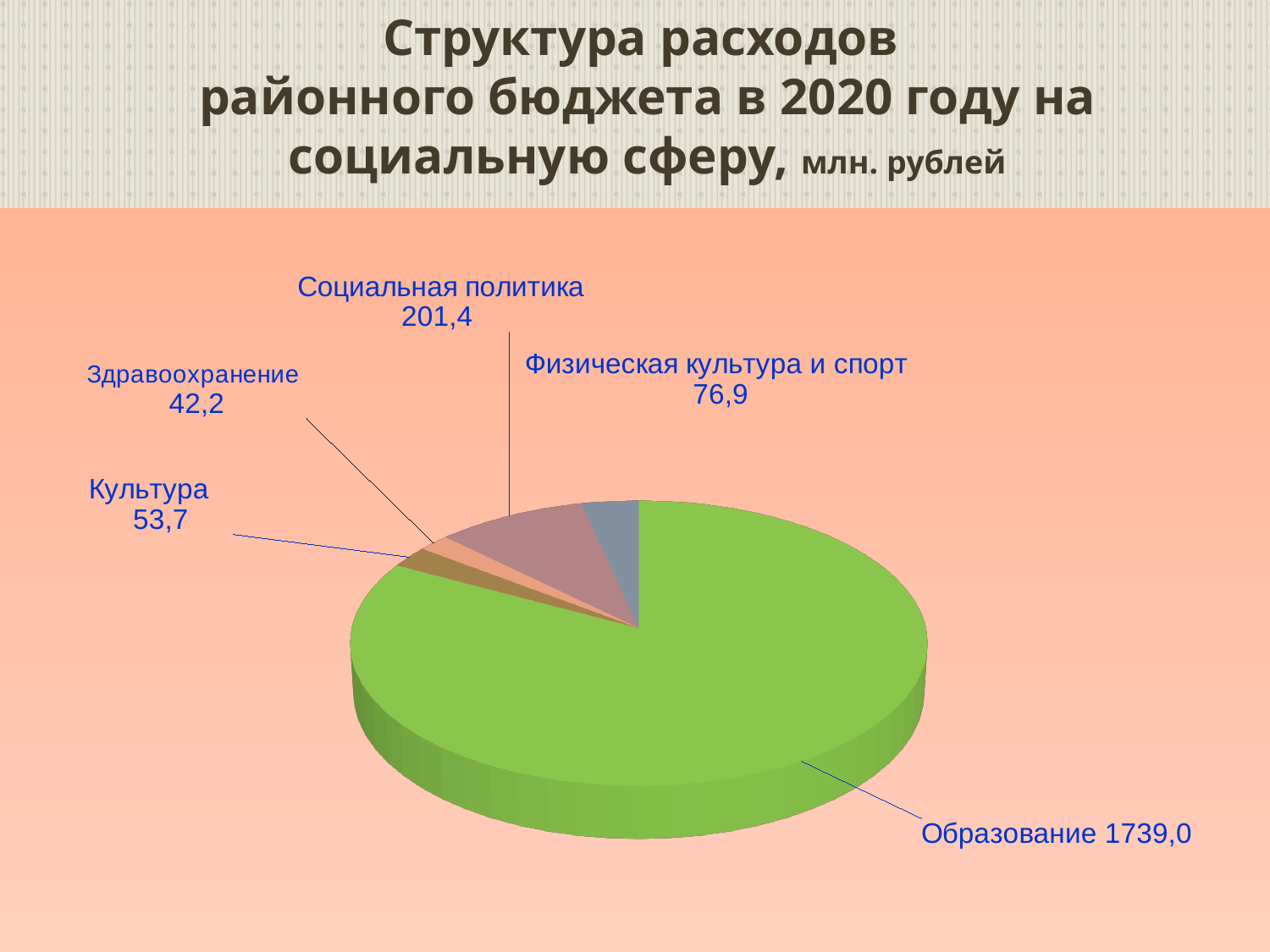
Which category has the largest share of the pie? Образование What is the value for Физическая культура и спорт? 76,9 Which is larger, the value for Физическая культура и спорт or the value for Культура? Физическая культура и спорт How many categories (slices) does the pie chart have? 5 What is the difference between the values for Культура and Здравоохранение? 11,5 Which category has the smallest value? Здравоохранение What is the value for Социальная политика? 201,4 In what units are the values on the chart given, according to the title? млн. рублей What is the difference between the values for Образование and Социальная политика? 1537,6 What kind of chart is shown on the slide? Pie chart What is the value for Здравоохранение? 42,2 What is the value for Образование? 1739,0